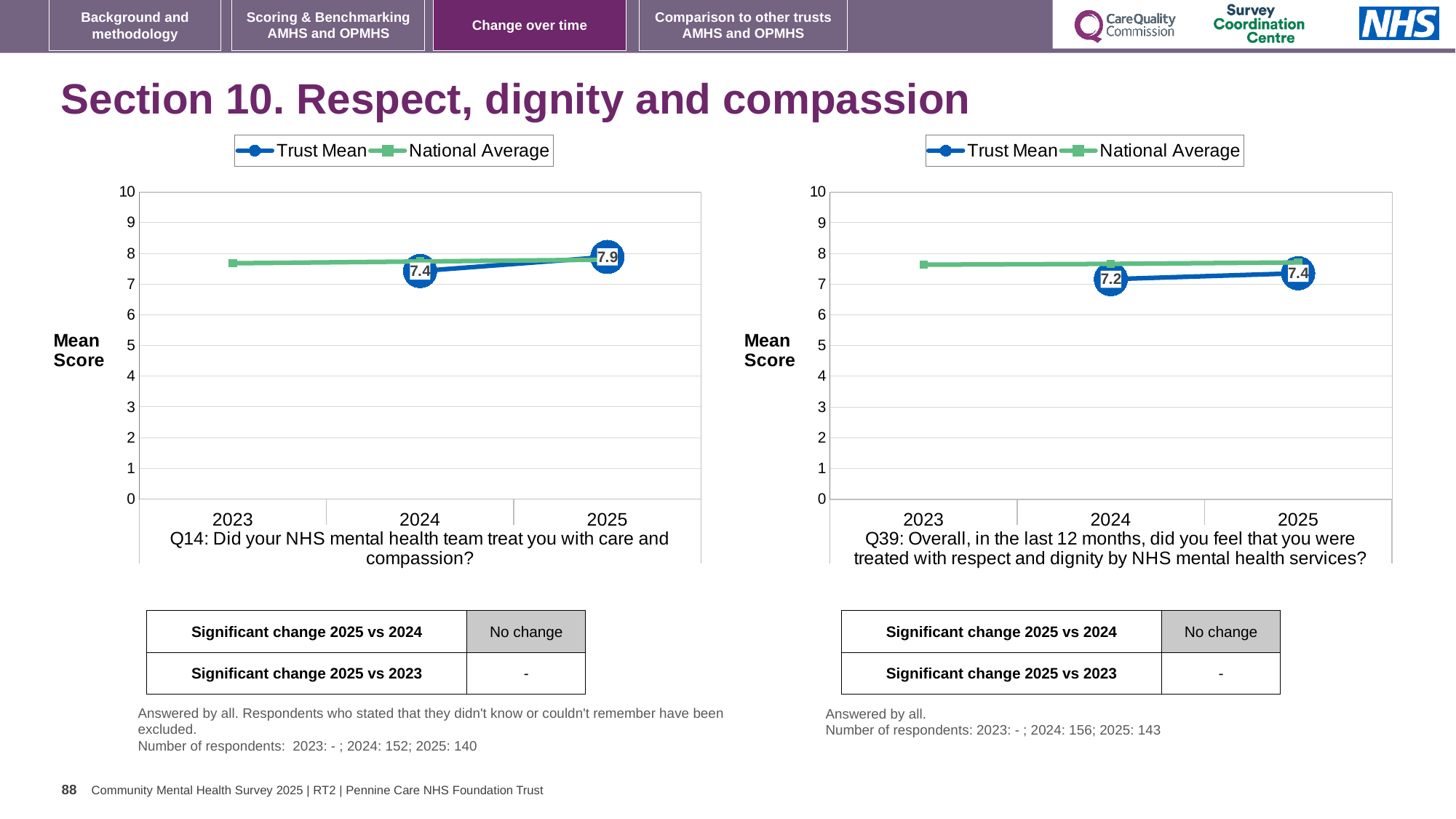
On the left chart (Q14), what is the Trust Mean score for 2024? 7.4 How many years are shown on the x axis of the left chart (Q14)? 3 What type of chart is used on the left (Q14)? line chart On the left chart (Q14), what is the Trust Mean score for 2025? 7.9 On the right chart (Q39), does the Trust Mean rise or fall from 2024 to 2025? rise On the right chart (Q39), what is the difference between the Trust Mean for 2025 and 2024? 0.2 How many series does the legend of the right chart (Q39) list? 2 On the left chart (Q14), which year has the higher Trust Mean, 2024 or 2025? 2025 On the right chart (Q39), is the National Average for 2023 greater or less than 5? greater On the right chart (Q39), what is the Trust Mean score for 2025? 7.4 On the right chart (Q39), what is the Trust Mean score for 2024? 7.2 On the left chart (Q14), by how much did the Trust Mean change from 2024 to 2025? 0.5